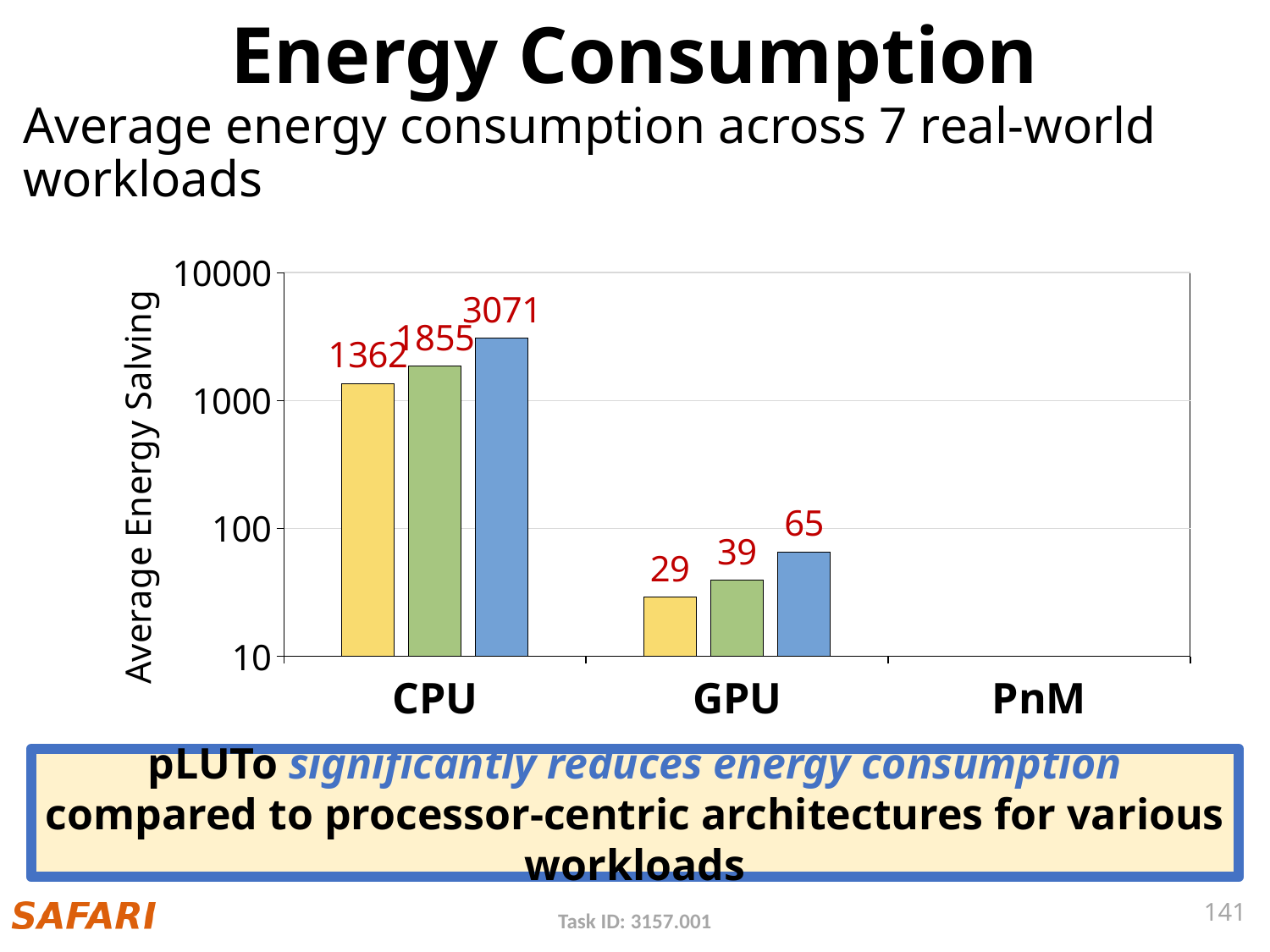
Which labelled bar has the lowest value in the chart? the yellow bar for GPU (29) Which is larger: the yellow bar for CPU or the blue bar for GPU? the yellow bar for CPU What is the value of the green bar for GPU? 39 What is the label of the y axis? Average Energy Salving Which bar has the highest value in the chart? the blue bar for CPU (3071) How many categories are shown on the x axis? 3 What is the value of the blue bar for CPU? 3071 What is the difference between the blue bar and the green bar for GPU? 26 What kind of chart is shown on the slide? bar chart What is the value of the green bar for CPU? 1855 What is the value of the yellow bar for GPU? 29 What is the difference between the blue bar and the yellow bar for CPU? 1709